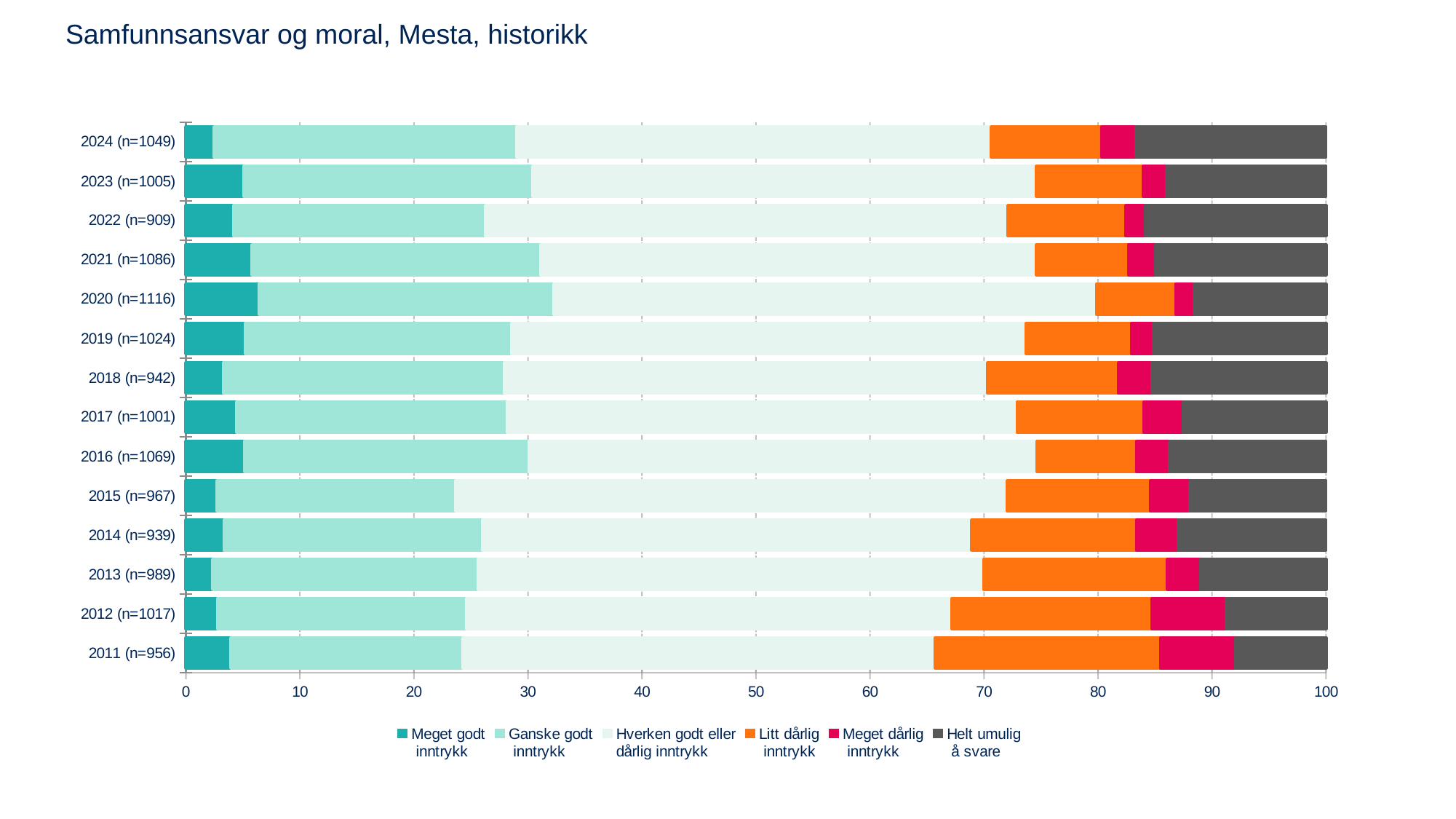
What is the sample size (n) shown for 2024? 1049 Which year has the larger 'Meget godt inntrykk' value, 2020 or 2024? 2020 Is the 'Litt dårlig inntrykk' value for 2011 greater or less than 10? greater Is the 'Meget godt inntrykk' value for 2020 greater or less than 10? less Which year has the larger 'Meget dårlig inntrykk' value, 2012 or 2023? 2012 Which year has the larger 'Helt umulig å svare' value, 2024 or 2012? 2024 What is the title of the chart? Samfunnsansvar og moral, Mesta, historikk What is the sample size (n) shown for 2011? 956 How many years (categories) are shown on the chart? 14 Is the 'Helt umulig å svare' value for 2024 greater or less than 10? greater How many series does the legend list? 6 What kind of chart is shown on the slide? Stacked bar chart